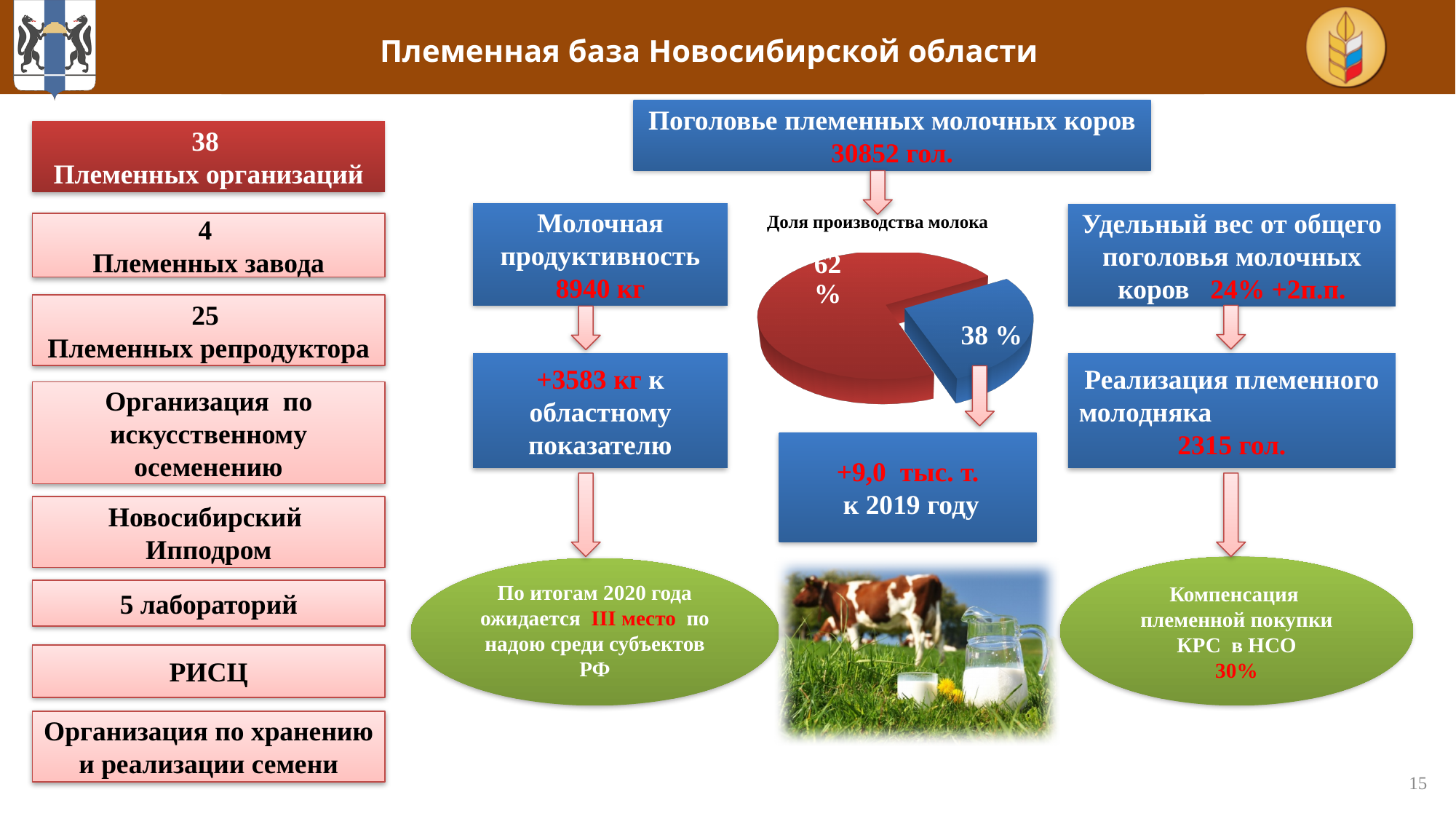
In the pie chart "Доля производства молока", what share is shown for the blue slice? 38 % In the pie chart "Доля производства молока", is the red slice or the blue slice larger? the red slice In the pie chart "Доля производства молока", what is the difference in percentage points between the red slice and the blue slice? 24 In the pie chart "Доля производства молока", which slice is pulled out (exploded) from the pie? the blue slice (38 %) How many slices does the pie chart "Доля производства молока" have? 2 In the pie chart "Доля производства молока", which slice is the largest? the red slice (62 %) In the pie chart "Доля производства молока", is the blue slice greater or less than 50%? less In the pie chart "Доля производства молока", what share is shown for the red slice? 62 % What kind of chart is shown under the heading "Доля производства молока"? pie chart What is the title of the pie chart in the centre of the slide? Доля производства молока In the pie chart "Доля производства молока", which slice is the smallest? the blue slice (38 %)